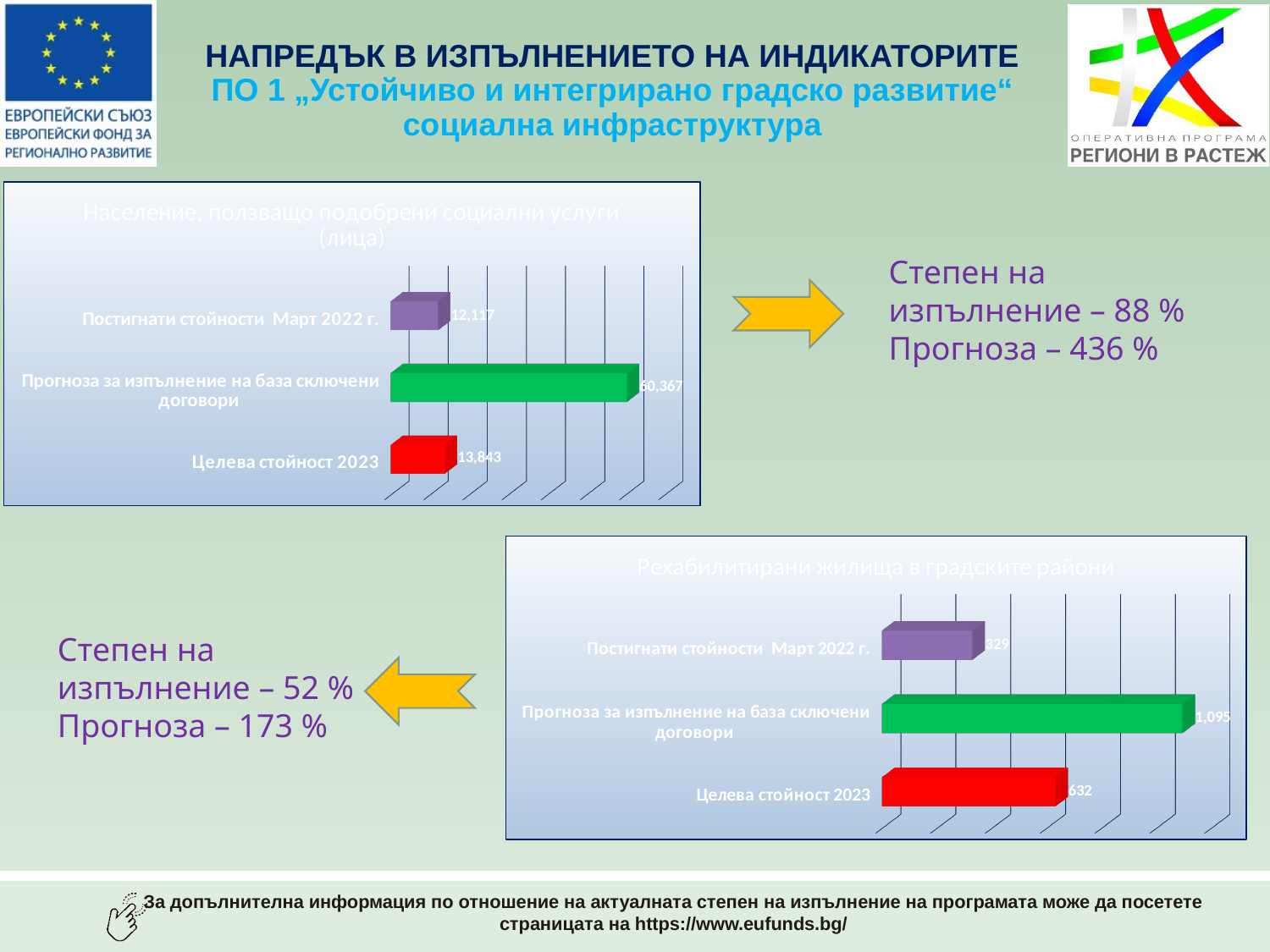
In the top chart, which category has the lowest value? Постигнати стойности Март 2022 г. In the top chart, what is the value for Постигнати стойности Март 2022 г.? 12,117 In the bottom chart, what is the value for Постигнати стойности Март 2022 г.? 329 How many categories does the bottom chart show? 3 In the bottom chart, what is the difference between Прогноза за изпълнение на база сключени договори and Целева стойност 2023? 463 In the bottom chart, which is larger: Целева стойност 2023 or Постигнати стойности Март 2022 г.? Целева стойност 2023 In the top chart, what is the value for Прогноза за изпълнение на база сключени договори? 60,367 In the bottom chart, what is the value for Прогноза за изпълнение на база сключени договори? 1,095 In the top chart, what is the value for Целева стойност 2023? 13,843 In the top chart, what is the difference between Целева стойност 2023 and Постигнати стойности Март 2022 г.? 1,726 In the top chart, which category has the highest value? Прогноза за изпълнение на база сключени договори In the bottom chart, what is the value for Целева стойност 2023? 632